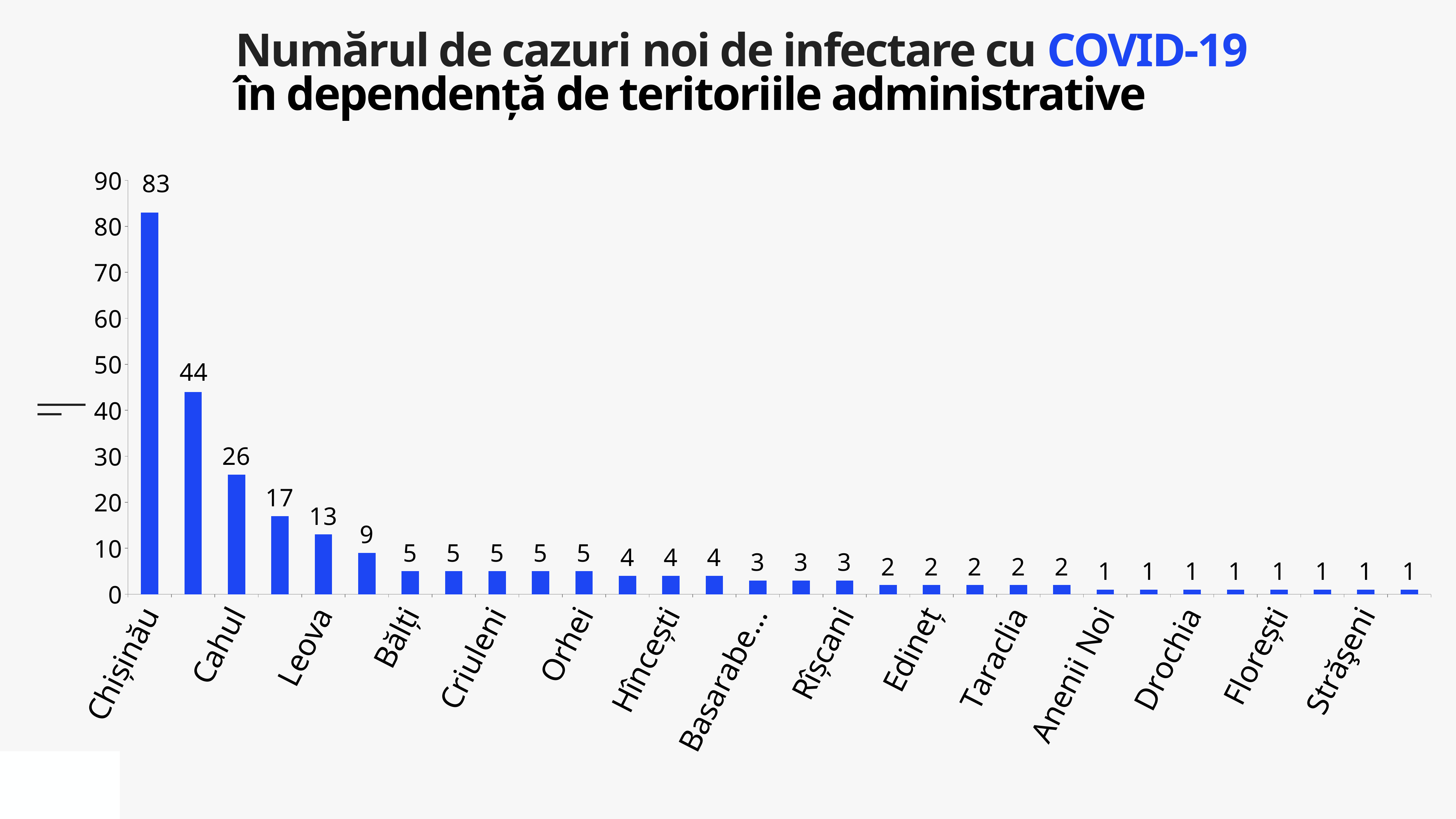
How many new COVID-19 cases are shown for Chișinău? 83 How many new COVID-19 cases are shown for Leova? 13 What kind of chart is shown on the slide? bar chart Which has more new cases, Chișinău or Cahul? Chișinău Which territory has the highest number of new COVID-19 cases? Chișinău Is the value for Chișinău greater or less than 80? greater Do the values rise or fall from left to right along the x axis? fall What is the value of the second-tallest bar in the chart? 44 What colour are the bars in the chart? blue How many new COVID-19 cases are shown for Cahul? 26 How many bars are plotted in the chart? 30 What is the difference between the number of cases in Chișinău and in Cahul? 57